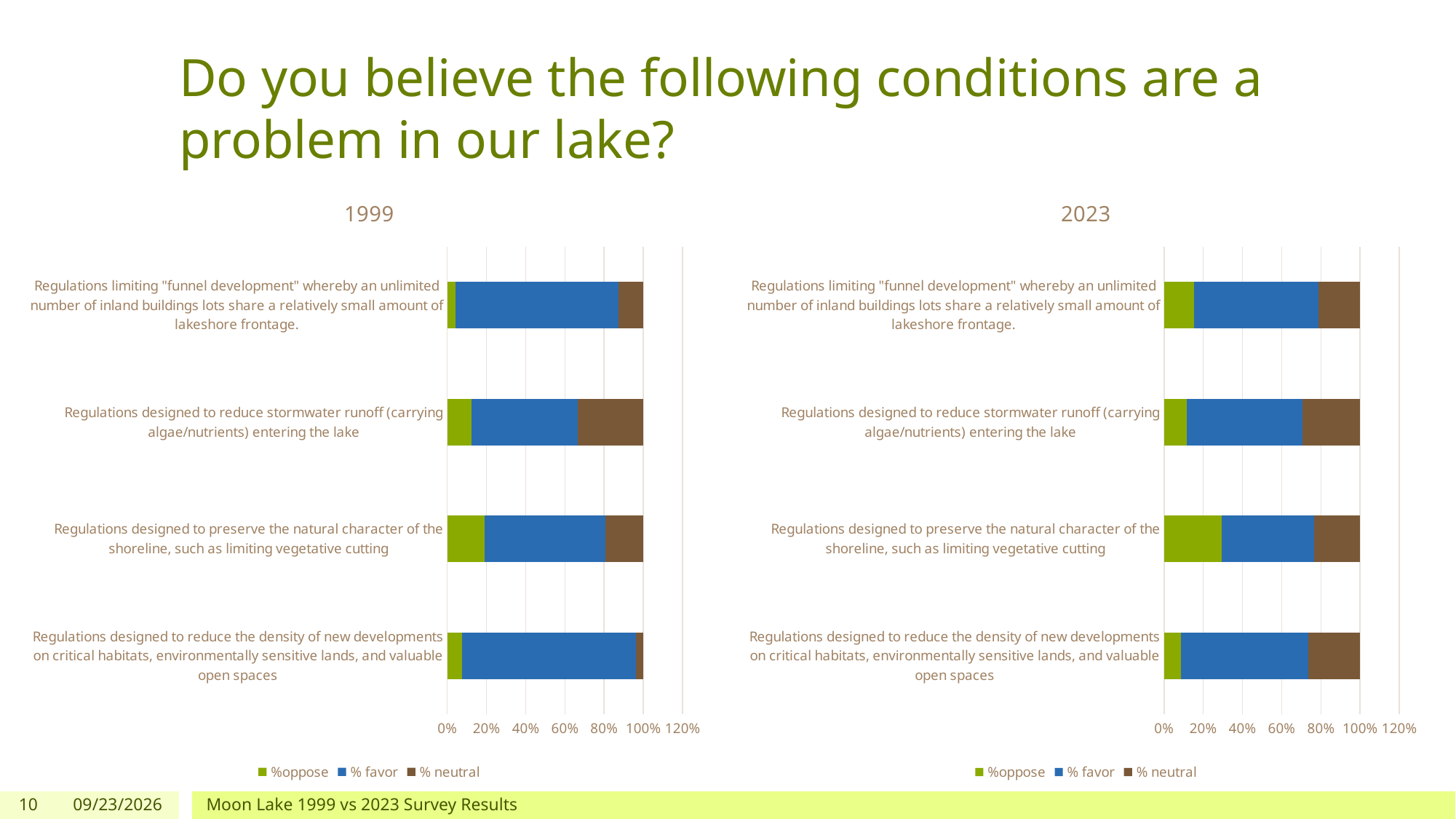
In the 2023 chart, is the %oppose value for "Regulations designed to preserve the natural character of the shoreline" greater or less than 20%? greater In the 2023 chart, is the %oppose value for "Regulations designed to reduce stormwater runoff" greater or less than 40%? less In the 1999 chart, which category has the lowest %oppose value? Regulations limiting "funnel development" whereby an unlimited number of inland buildings lots share a relatively small amount of lakeshore frontage. In the 1999 chart, which is larger: the % neutral value for "Regulations designed to reduce stormwater runoff" or for "Regulations designed to reduce the density of new developments"? Regulations designed to reduce stormwater runoff How many categories are shown in the 2023 chart? 4 In the 2023 chart, which is larger: the %oppose value for "Regulations designed to preserve the natural character of the shoreline" or for "Regulations designed to reduce the density of new developments"? Regulations designed to preserve the natural character of the shoreline In the 2023 chart, which category has the highest %oppose value? Regulations designed to preserve the natural character of the shoreline, such as limiting vegetative cutting What are the legend entries of the 2023 chart? %oppose, % favor, % neutral How many series does the legend of the 1999 chart list? 3 In the 1999 chart, is the %oppose value for "Regulations limiting funnel development" greater or less than 20%? less What are the titles of the two charts on the slide? 1999 and 2023 What kind of chart is the 1999 chart? Stacked bar chart